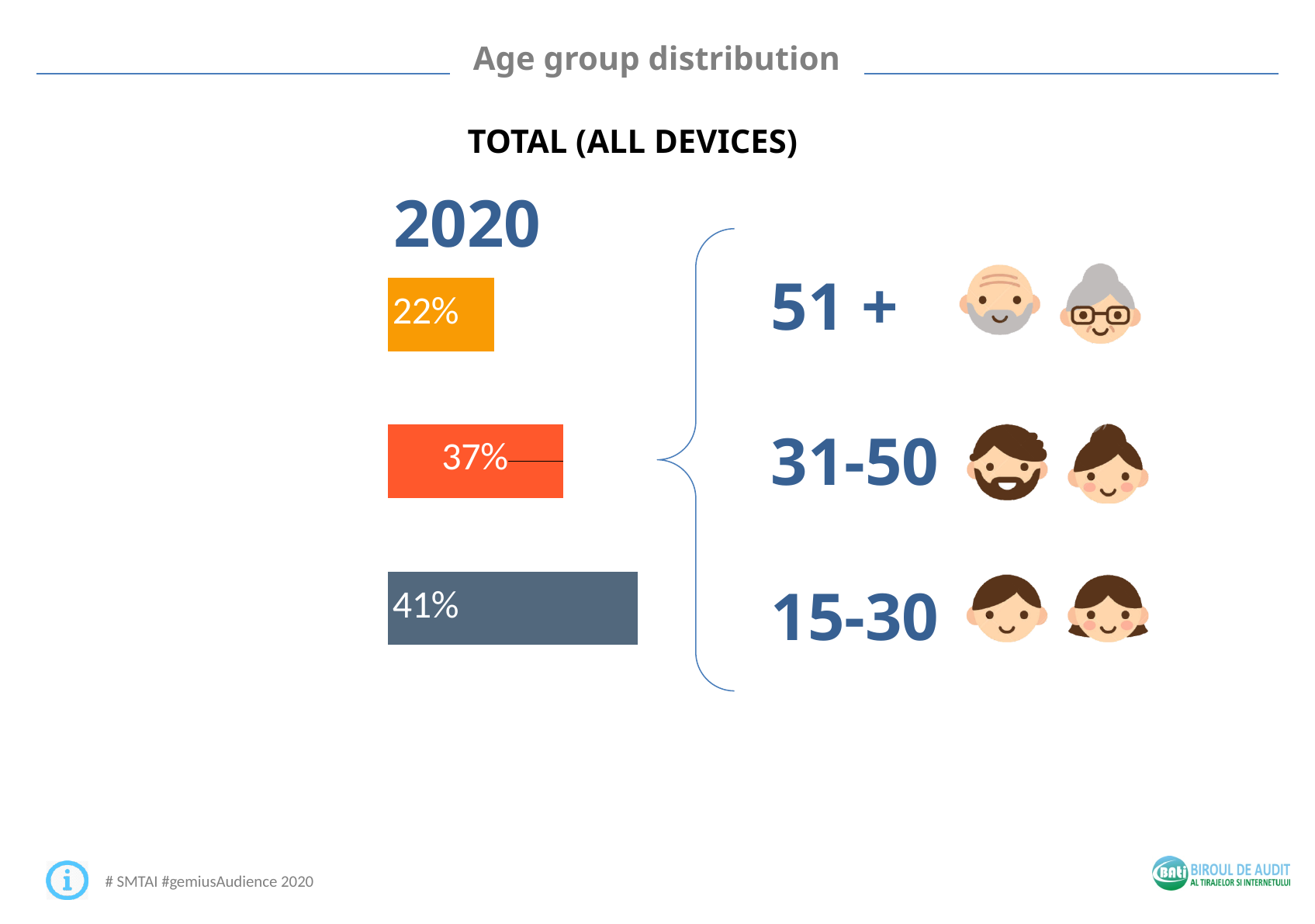
Which age group has the largest share? 15-30 What is the difference in percentage points between the 31-50 and 51+ age groups? 15 What percentage of the audience is in the 15-30 age group? 41% What is the difference in percentage points between the 15-30 and 51+ age groups? 19 How many age groups are shown in the chart? 3 What is the subtitle above the chart? TOTAL (ALL DEVICES) Which age group has a larger share, 31-50 or 51+? 31-50 What percentage of the audience is in the 51+ age group? 22% What year does the chart's data refer to? 2020 What percentage of the audience is in the 31-50 age group? 37% Which age group has the smallest share? 51 + What kind of chart is used to show the age group distribution? Bar chart